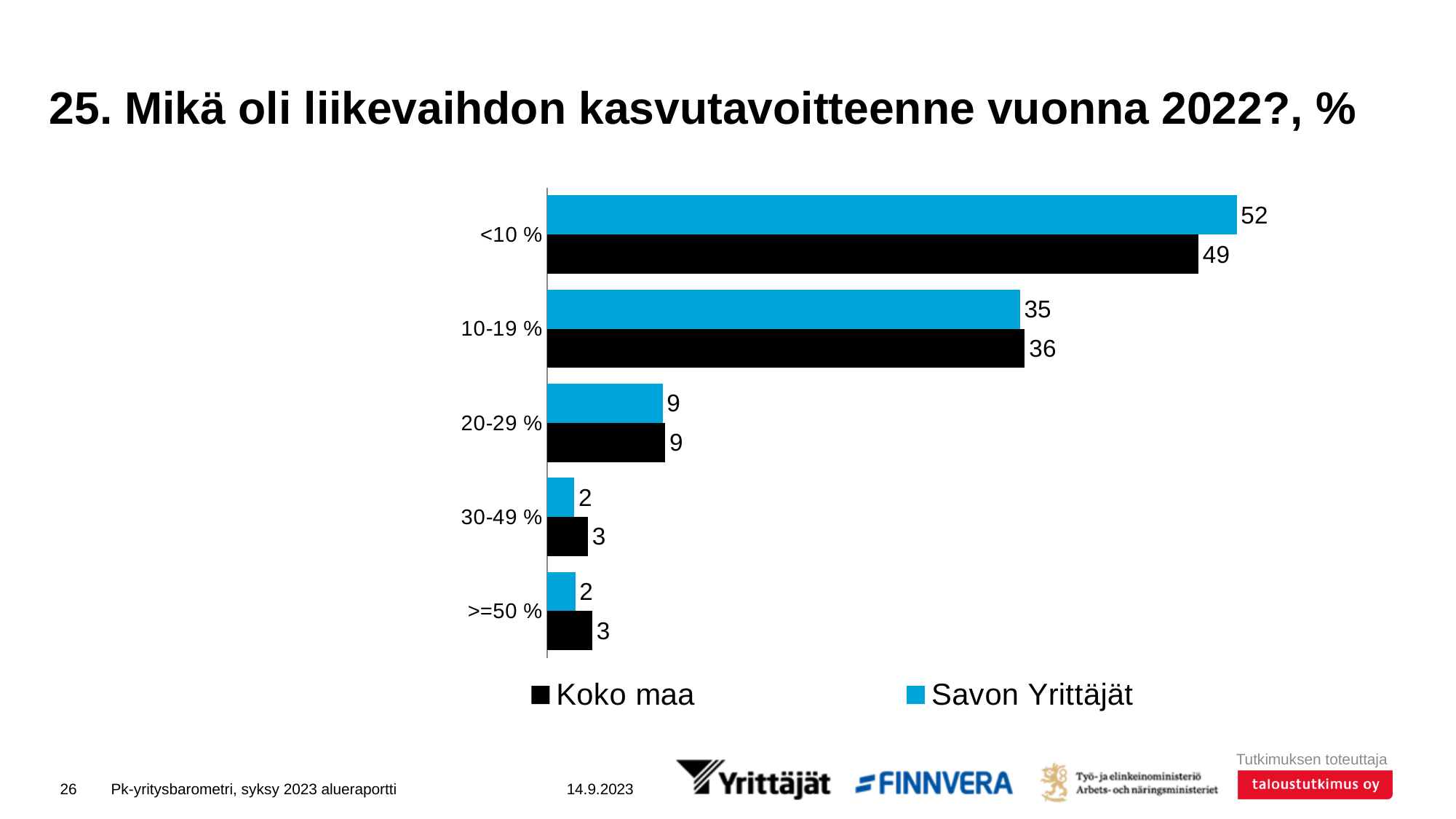
Which is larger in the 10-19 % category, Koko maa or Savon Yrittäjät? Koko maa Which colour represents Savon Yrittäjät in the legend? blue What is the value for Koko maa in the 30-49 % category? 3 What is the difference between Savon Yrittäjät and Koko maa in the <10 % category? 3 What kind of chart is shown on the slide? bar chart How many categories are shown on the chart? 5 How many series does the legend list? 2 What is the value for Koko maa in the 10-19 % category? 36 What is the value for Savon Yrittäjät in the >=50 % category? 2 What is the value for Savon Yrittäjät in the <10 % category? 52 Which category has the highest value for Savon Yrittäjät? <10 % What is the difference between Koko maa and Savon Yrittäjät in the 20-29 % category? 0